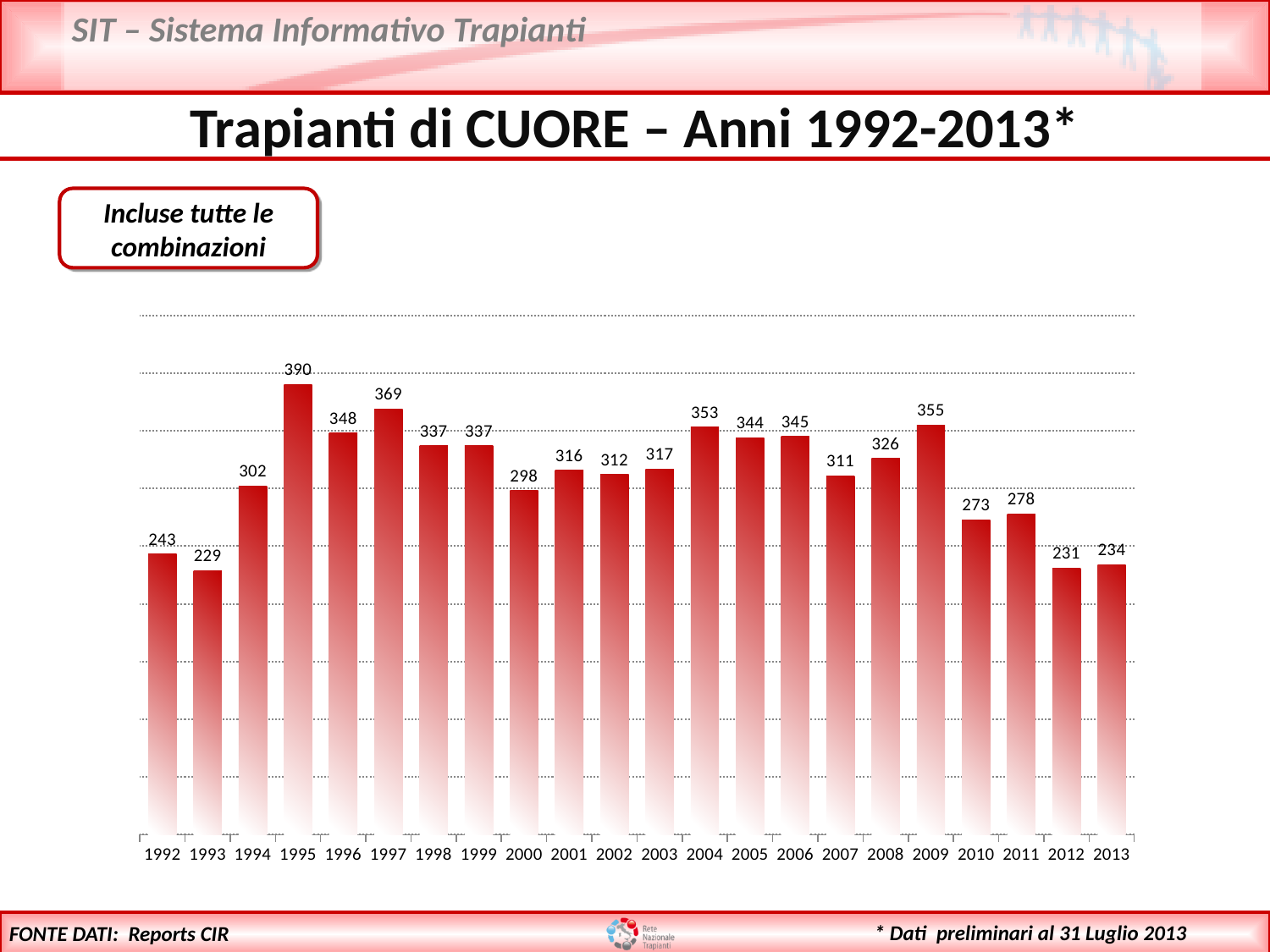
Which is larger, the value for 1997 or the value for 2004? 1997 What is the value for 2013? 234 How many years are shown on the x axis? 22 What kind of chart is shown on the slide? Bar chart Which year has the lowest value? 1993 Which year has the highest value? 1995 What is the value for 1995? 390 What is the difference between the values for 1995 and 1993? 161 Which is larger, the value for 2008 or the value for 2011? 2008 What is the value for 2009? 355 What is the title of the chart on the slide? Trapianti di CUORE – Anni 1992-2013* What is the difference between the values for 2009 and 2010? 82